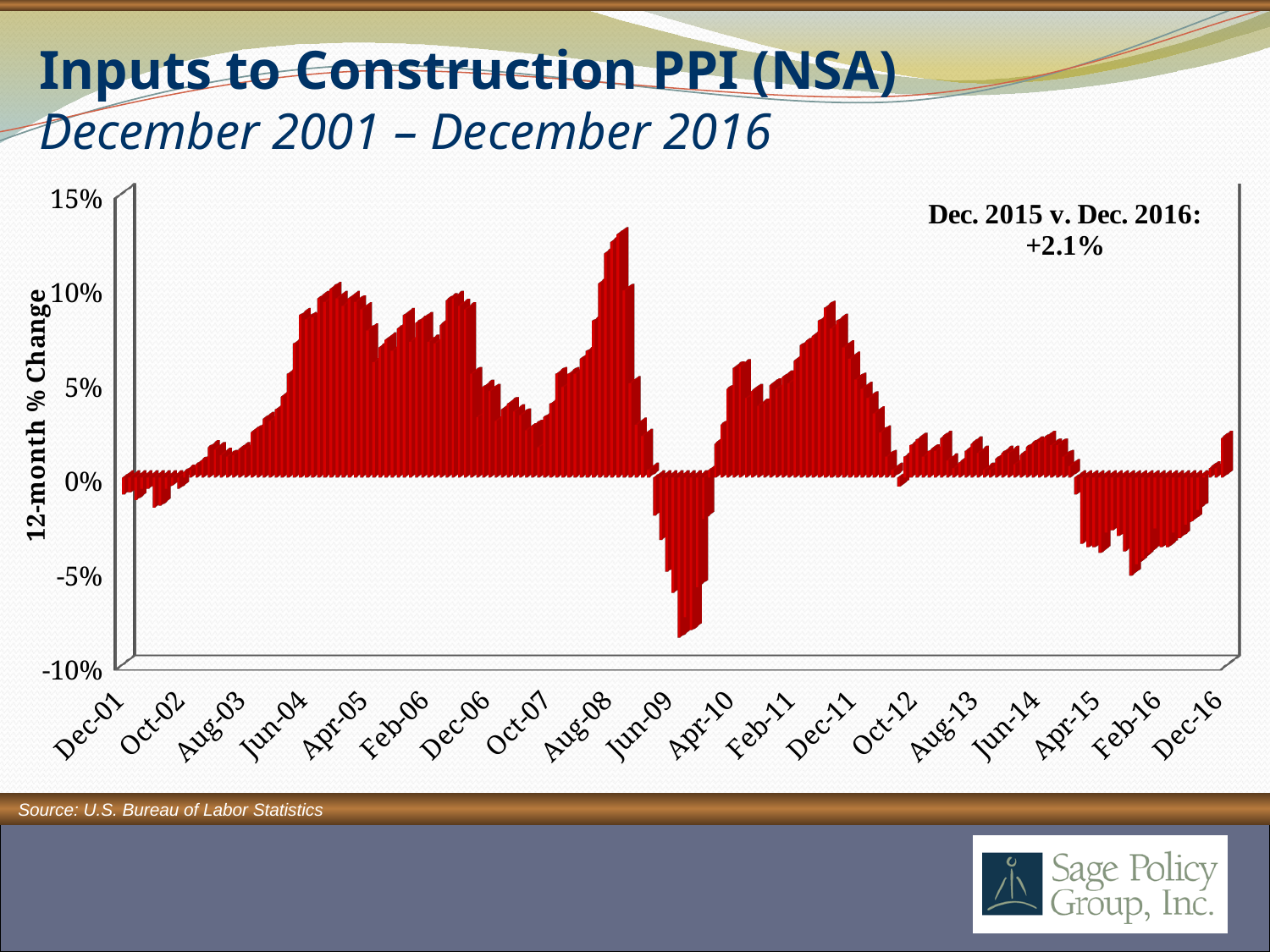
Is the value for Aug-08 greater or less than 10%? greater Is the value for Jun-09 greater or less than 0%? less Is the value for Apr-05 greater or less than 5%? greater What is the change from Dec. 2015 to Dec. 2016 shown in the annotation? +2.1% Which labelled period on the x axis has the highest 12-month % change? Aug-08 What is the title of the y axis? 12-month % Change Between Feb-16 and Dec-16, do the values rise or fall? rise What kind of chart is shown on the slide? bar chart How many date labels are shown on the x axis? 19 What source is cited for the chart data? U.S. Bureau of Labor Statistics